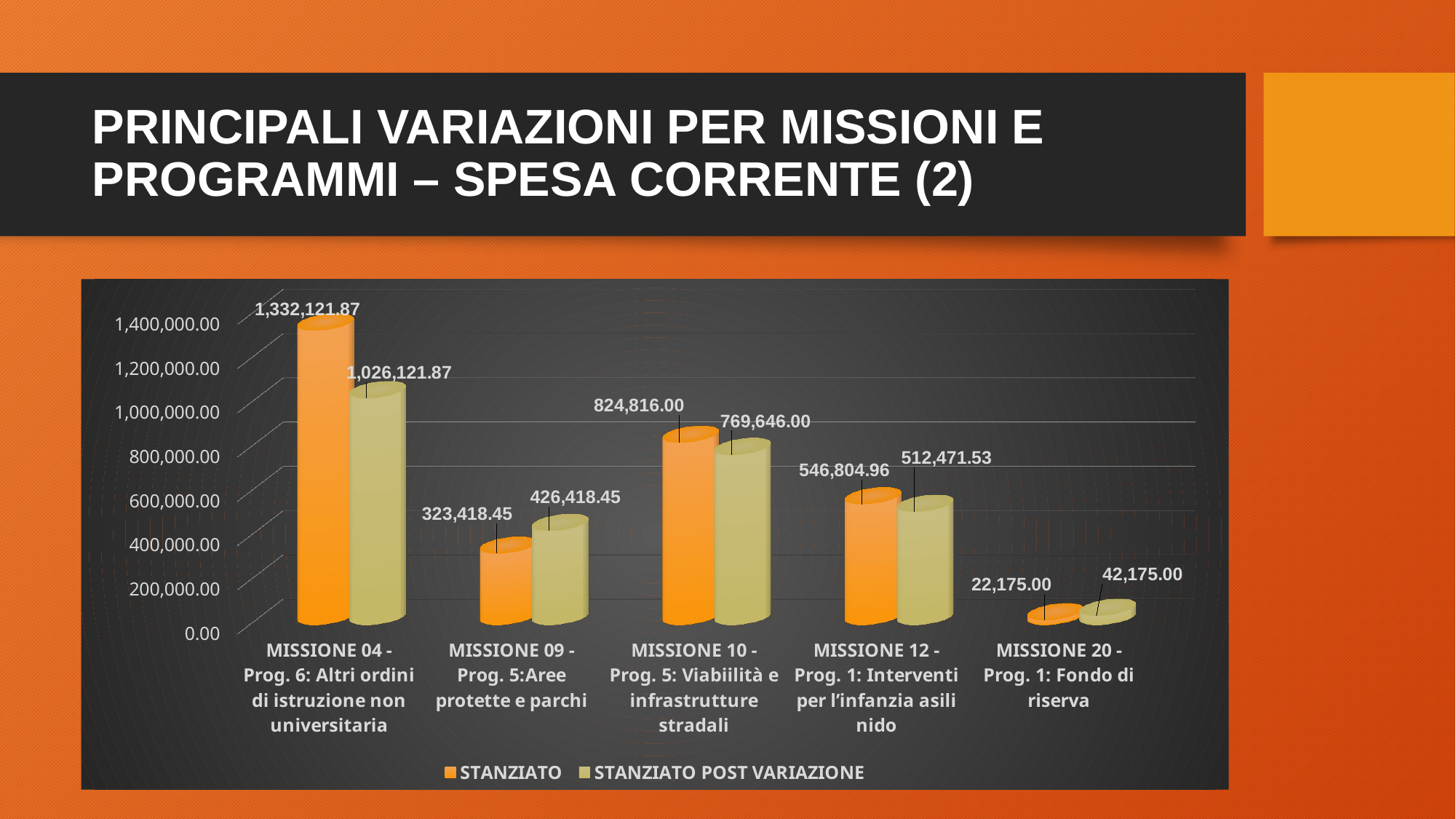
What is the difference between the STANZIATO and STANZIATO POST VARIAZIONE values for MISSIONE 04 - Prog. 6? 306,000.00 Which category has the highest STANZIATO value? MISSIONE 04 - Prog. 6: Altri ordini di istruzione non universitaria How many series does the chart legend list? 2 What is the STANZIATO value for MISSIONE 20 - Prog. 1: Fondo di riserva? 22,175.00 What kind of chart is shown on the slide? Bar chart How many categories are shown on the x axis of the chart? 5 What is the STANZIATO POST VARIAZIONE value for MISSIONE 09 - Prog. 5: Aree protette e parchi? 426,418.45 Which category has the lowest STANZIATO POST VARIAZIONE value? MISSIONE 20 - Prog. 1: Fondo di riserva For MISSIONE 09 - Prog. 5: Aree protette e parchi, which is larger: STANZIATO or STANZIATO POST VARIAZIONE? STANZIATO POST VARIAZIONE What is the STANZIATO POST VARIAZIONE value for MISSIONE 10 - Prog. 5: Viabilità e infrastrutture stradali? 769,646.00 What is the difference between the STANZIATO POST VARIAZIONE and STANZIATO values for MISSIONE 20 - Prog. 1: Fondo di riserva? 20,000.00 What is the STANZIATO value for MISSIONE 04 - Prog. 6: Altri ordini di istruzione non universitaria? 1,332,121.87